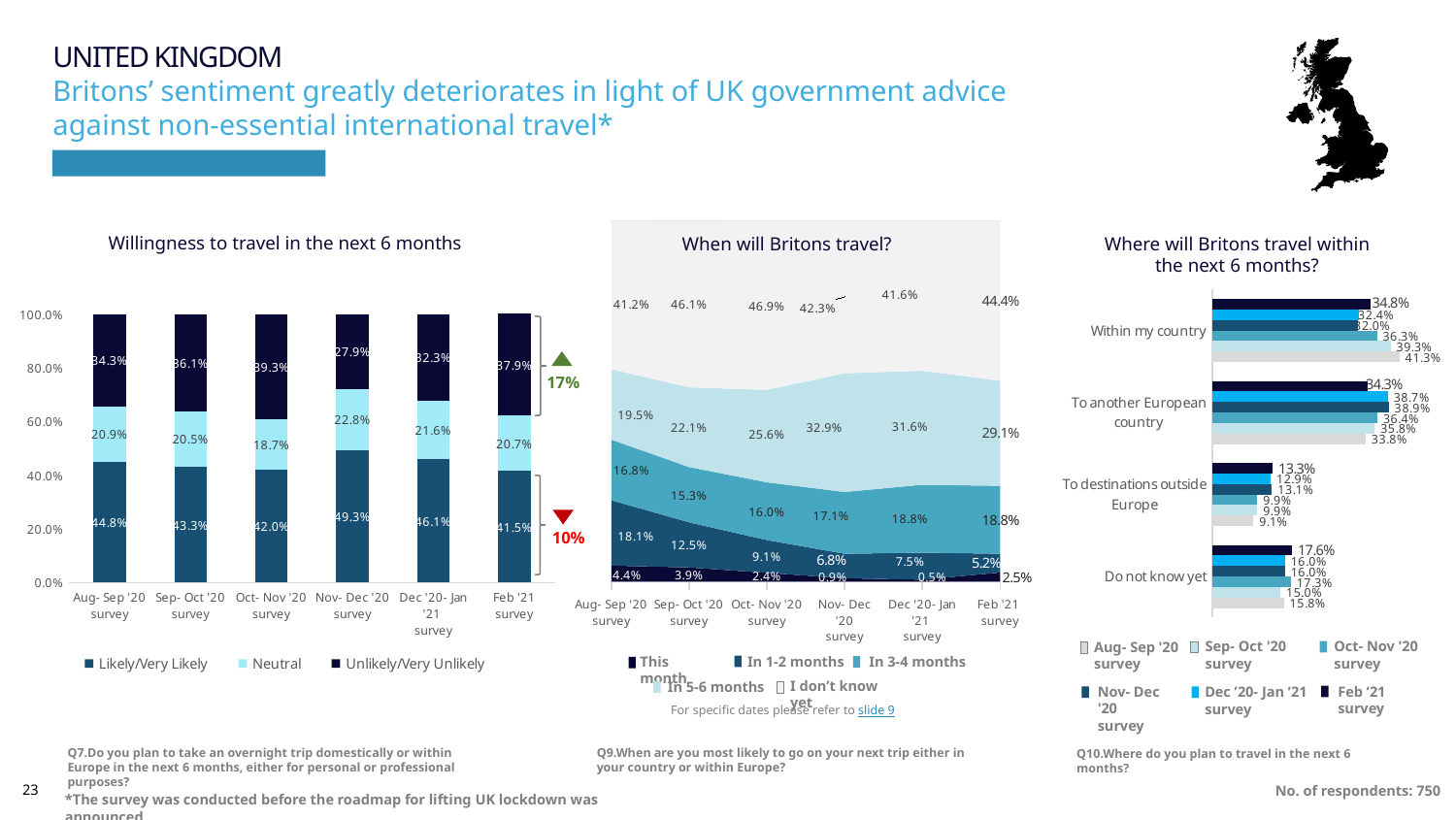
In the 'When will Britons travel?' chart, what is the 'In 5-6 months' value for the Nov-Dec '20 survey? 32.9% In the 'Willingness to travel in the next 6 months' chart, how many series does the legend list? 3 In the 'Willingness to travel in the next 6 months' chart, which survey has the highest Likely/Very Likely value? Nov-Dec '20 survey In the 'When will Britons travel?' chart, which survey has the lowest 'This month' value? Dec '20-Jan '21 survey In the 'Willingness to travel in the next 6 months' chart, what is the Likely/Very Likely value for the Feb '21 survey? 41.5% In the 'When will Britons travel?' chart, how many survey periods are shown on the x axis? 6 In the 'When will Britons travel?' chart, does the 'In 1-2 months' value generally rise or fall from the Aug-Sep '20 survey to the Feb '21 survey? fall In the 'When will Britons travel?' chart, what is the 'I don't know yet' value for the Oct-Nov '20 survey? 46.9% In the 'Where will Britons travel within the next 6 months?' chart, what is the highest value shown for 'Within my country'? 41.3% In the 'Willingness to travel in the next 6 months' chart, what is the Unlikely/Very Unlikely value for the Nov-Dec '20 survey? 27.9% What type of chart is 'Where will Britons travel within the next 6 months?'? bar chart In the 'Willingness to travel in the next 6 months' chart, what is the difference between the Likely/Very Likely values for the Nov-Dec '20 survey and the Feb '21 survey? 7.8%